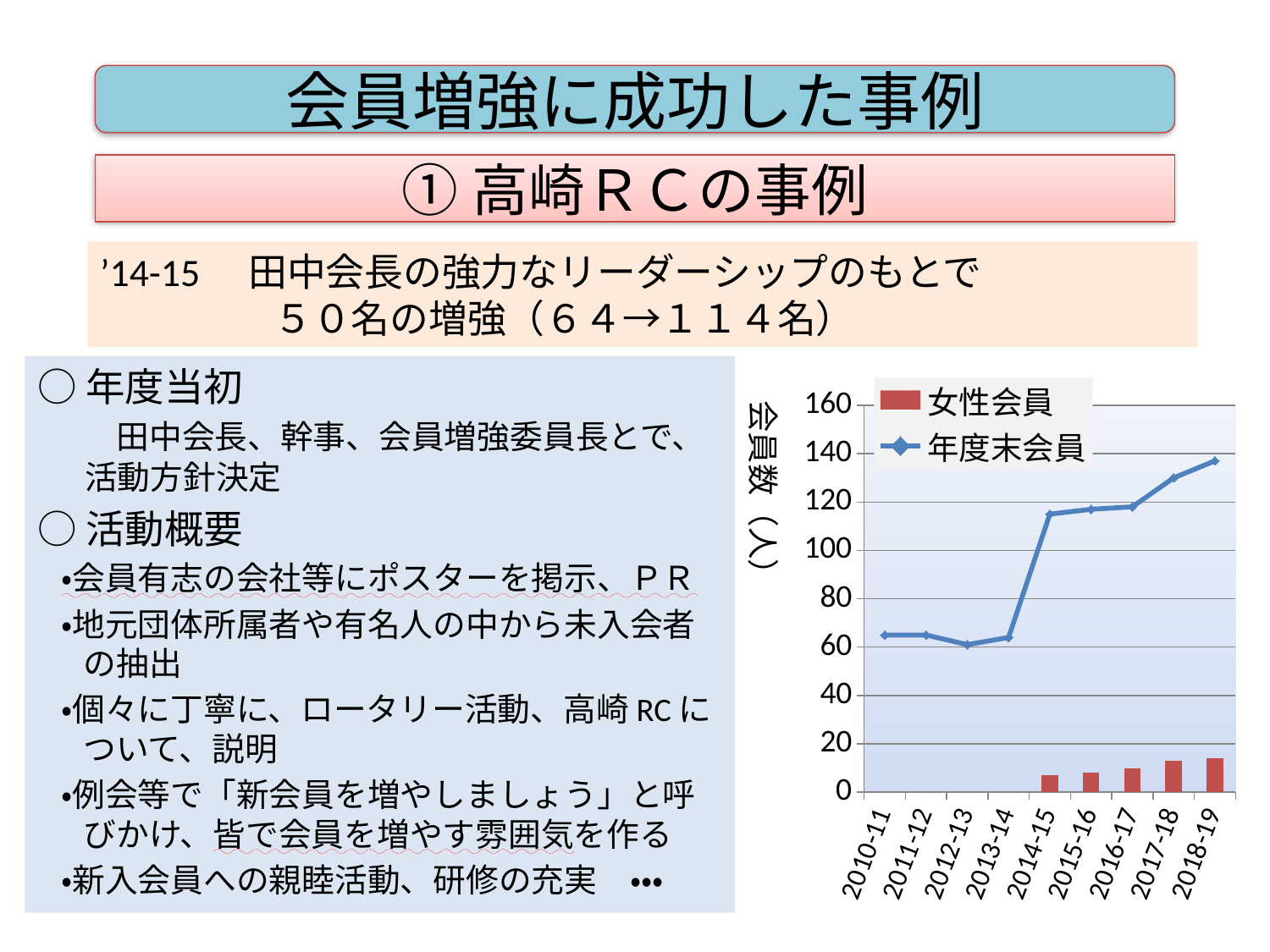
What are the two entries in the chart legend? 女性会員 and 年度末会員 Is the 女性会員 value for 2018-19 greater or less than 20? less Is the 年度末会員 value for 2018-19 greater or less than 120? greater In which year is the 年度末会員 line at its lowest? 2012-13 Which year has the larger 年度末会員 value, 2013-14 or 2014-15? 2014-15 How many series does the chart legend list? 2 Is the 年度末会員 value for 2014-15 greater or less than 100? greater In which year is the 年度末会員 line at its highest? 2018-19 What kind of chart is shown on the slide? A combined line and bar chart How many year categories are shown on the x axis of the chart? 9 Does the 年度末会員 line rise or fall from 2013-14 to 2018-19? It rises